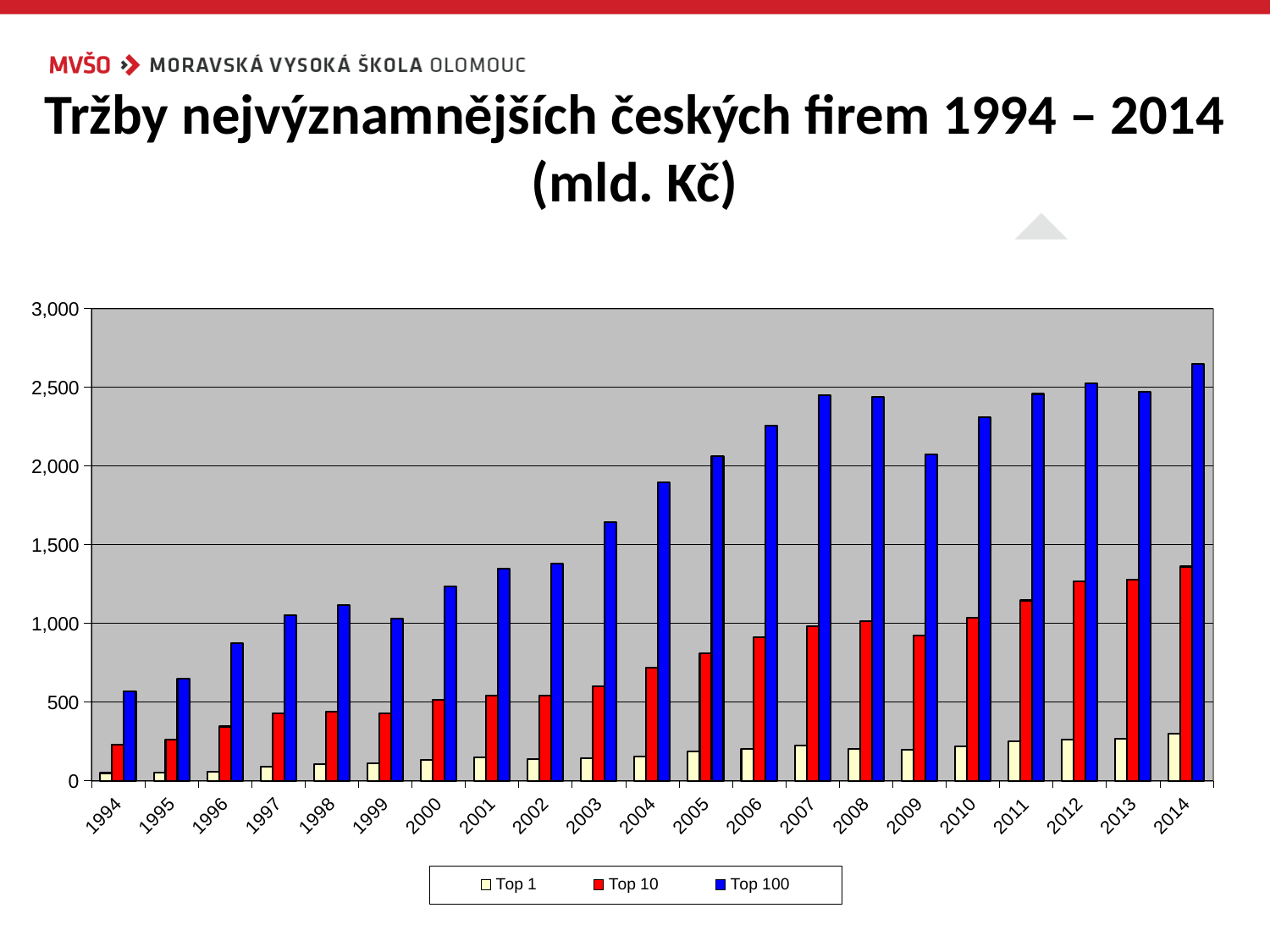
What kind of chart is shown on the slide? bar chart How many series does the legend list? 3 Is the value for Top 1 in 2014 greater or less than 500? less Is the value for Top 100 in 2003 greater or less than 1,500? greater Which is larger, the Top 100 value for 2007 or for 2009? 2007 Which year has the lowest value for Top 100? 1994 Which year has the highest value for Top 10? 2014 Does the Top 100 series generally rise or fall from 1994 to 2014? rise Is the value for Top 10 in 2014 greater or less than 1,500? less Which year has the highest value for Top 100? 2014 How many years are shown on the x axis? 21